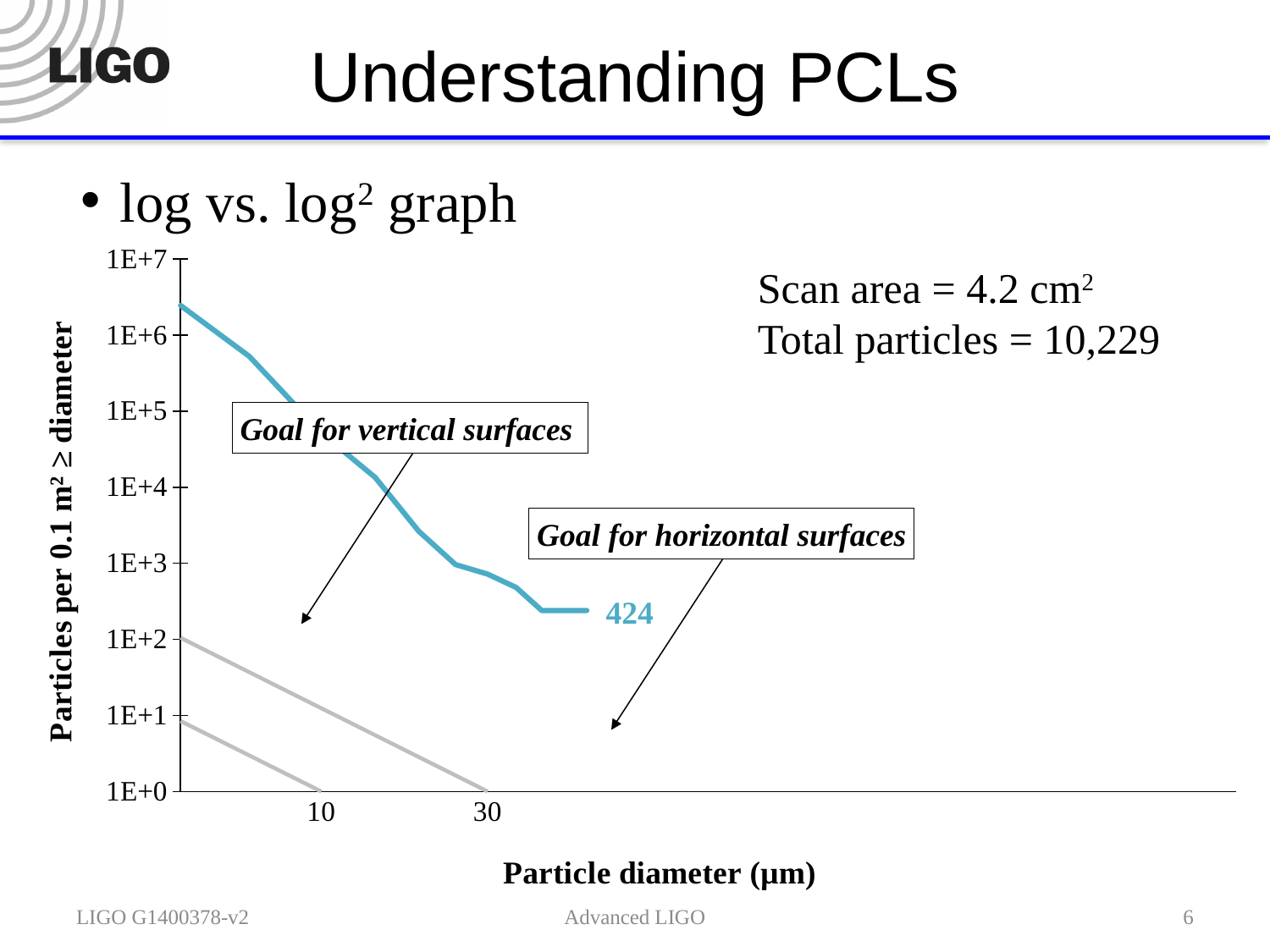
How many tick labels are shown on the x axis of the chart? 2 What is the title of the x axis of the chart? Particle diameter (µm) What kind of chart is shown on the slide? line chart Which goal line is higher on the chart, the goal for vertical surfaces or the goal for horizontal surfaces? Goal for vertical surfaces At which particle diameter does the 'Goal for horizontal surfaces' line reach 1E+0? 10 Do the values of the blue measured line rise or fall as particle diameter increases? fall At the left edge of the chart, which y-axis tick does the 'Goal for horizontal surfaces' line start at? 1E+1 At the left edge of the chart, which y-axis tick does the 'Goal for vertical surfaces' line start at? 1E+2 Is the starting value of the blue measured line at the left edge of the chart greater or less than 1E+6? greater What value is printed as the data label at the right end of the blue measured line? 424 At which particle diameter does the 'Goal for vertical surfaces' line reach 1E+0? 30 Is the value of the blue measured line at a particle diameter of 10 µm greater or less than 1E+4? greater